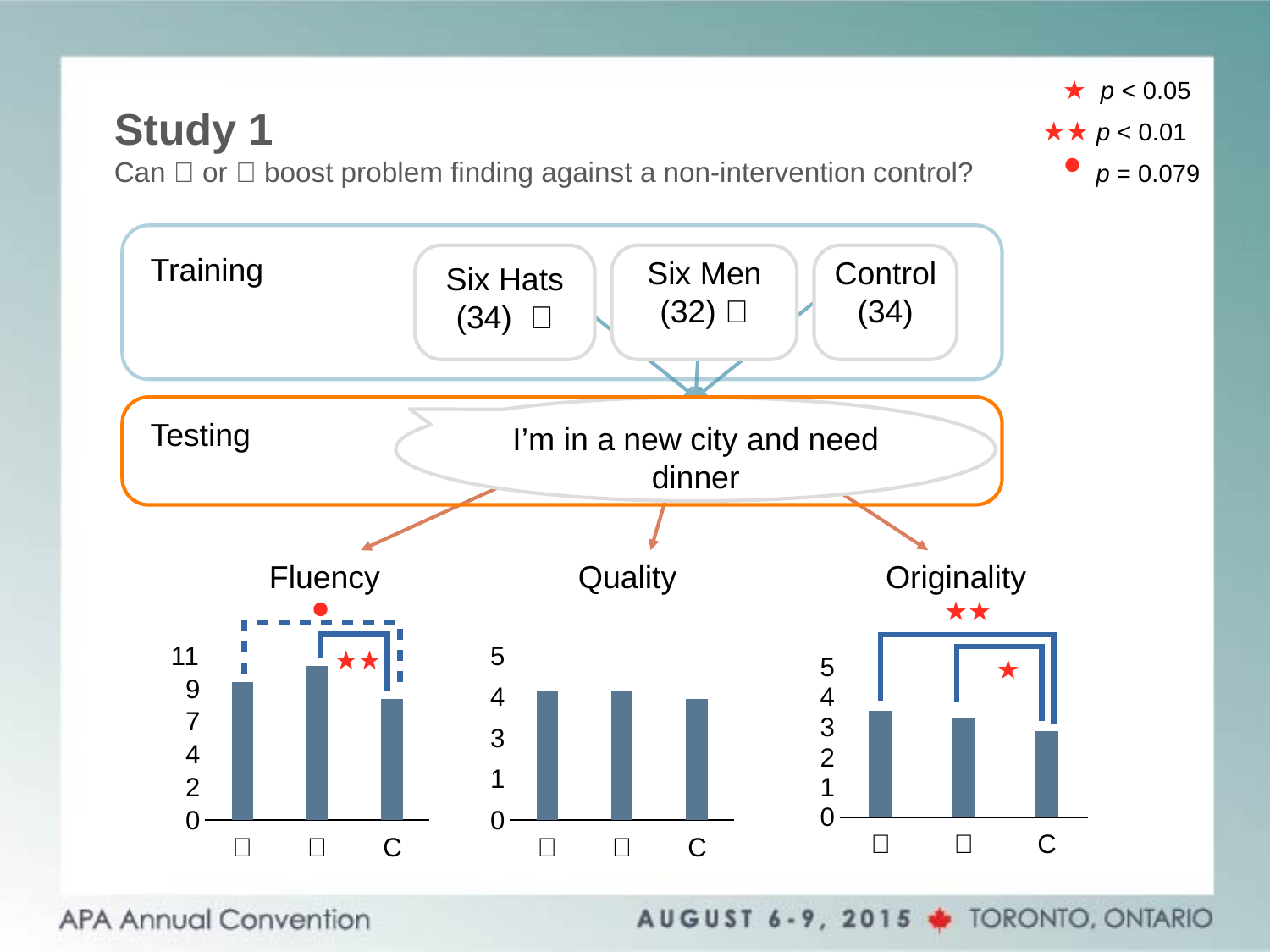
In the Fluency chart, which category has the lowest bar? C What kind of chart is the Fluency chart? bar chart What are the titles of the three bar charts on the slide, from left to right? Fluency, Quality, Originality In the Fluency chart, is the value for C greater or less than 7? greater How many bars does the Quality chart have? 3 In the Originality chart, is the value for C greater or less than 4? less In the Quality chart, is the value for C greater or less than 3? greater In the Originality chart, which category has the lowest bar? C How many bars does the Originality chart have? 3 Which of the three charts has no significance stars above it? Quality In the Originality chart, do the bar values rise or fall from left to right? fall